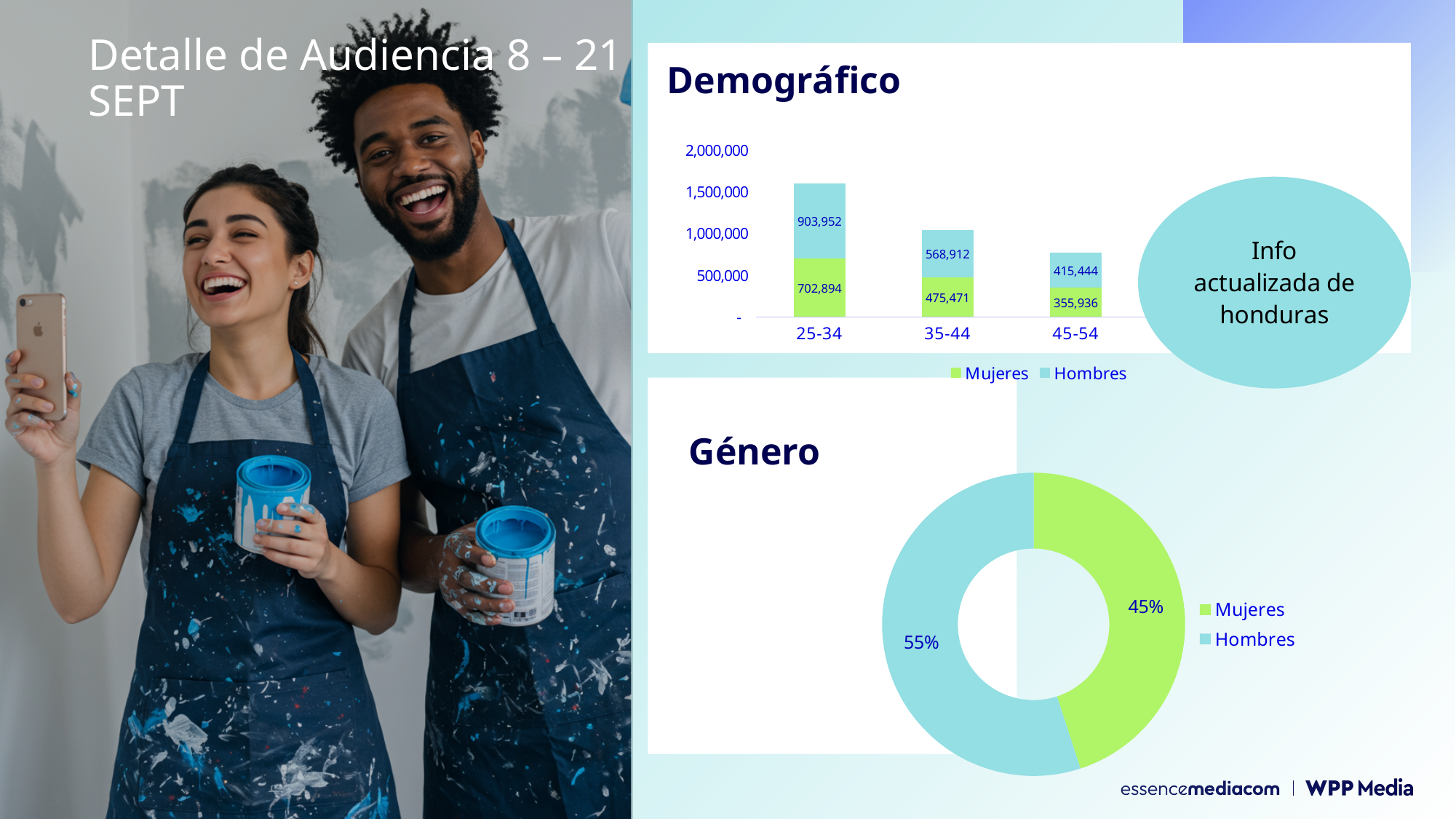
In the Demográfico chart, what is the difference between Hombres and Mujeres in the 25-34 age group? 201,058 How many series does the legend of the Demográfico chart list? 2 In the Demográfico chart, which age group has the highest value for Hombres? 25-34 In the Demográfico chart, what is the value for Mujeres in the 35-44 age group? 475,471 In the Género chart, what share is Hombres? 55% In the Demográfico chart, what is the value for Mujeres in the 45-54 age group? 355,936 In the Demográfico chart, what is the value for Hombres in the 25-34 age group? 903,952 In the Demográfico chart, which is larger in the 45-54 age group, Mujeres or Hombres? Hombres What kind of chart is the Género chart? Donut chart In the Demográfico chart, what is the total of the stacked bar for the 35-44 age group? 1,044,383